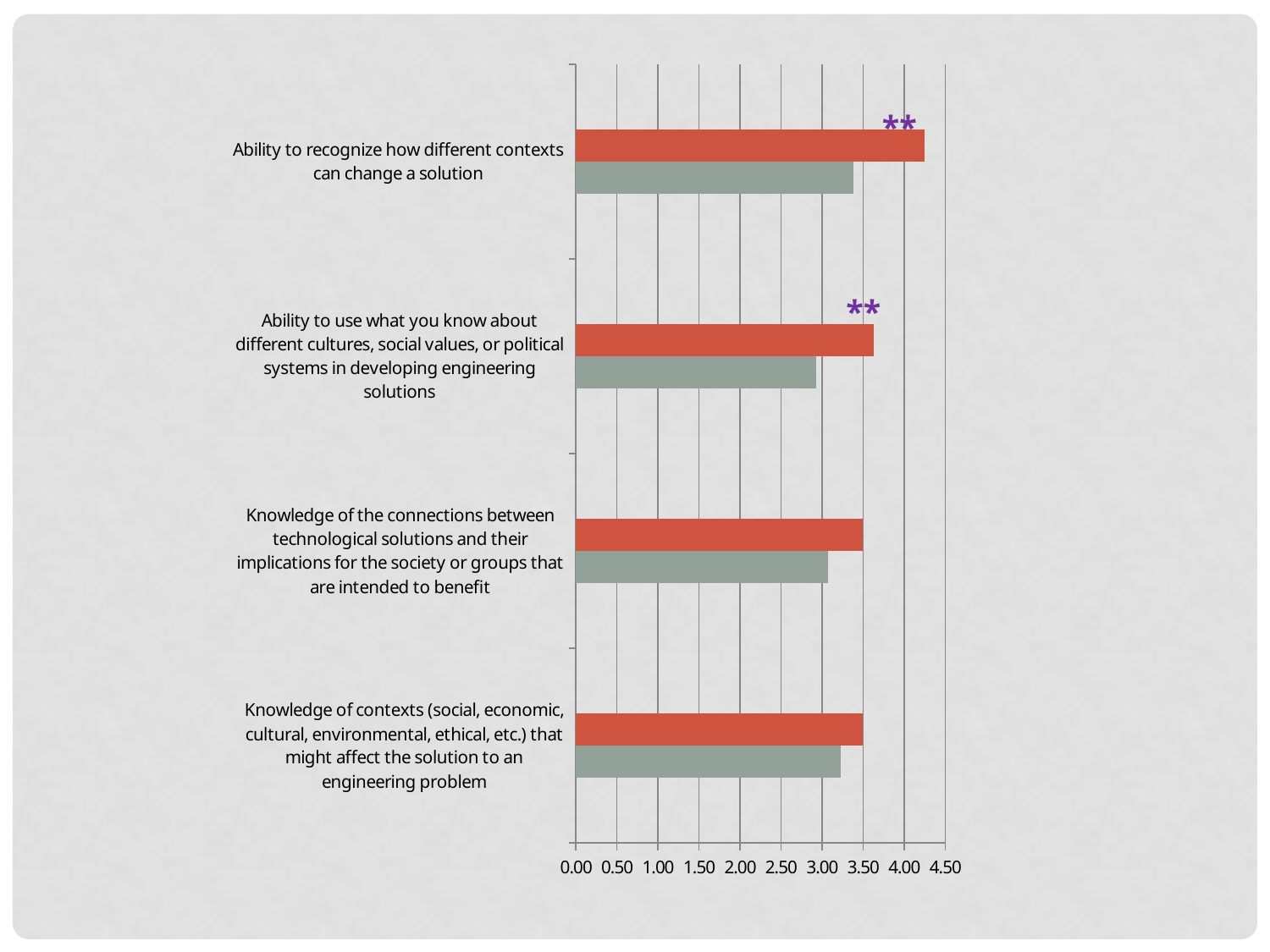
Which is longer: the red bar for "Ability to recognize how different contexts can change a solution" or the red bar for "Ability to use what you know about different cultures, social values, or political systems in developing engineering solutions"? Ability to recognize how different contexts can change a solution Is the gray bar for "Ability to recognize how different contexts can change a solution" greater or less than 3.50? less Is the red bar for "Knowledge of contexts (social, economic, cultural, environmental, ethical, etc.) that might affect the solution to an engineering problem" greater or less than 3.00? greater Is the red bar for "Ability to recognize how different contexts can change a solution" greater or less than 4.00? greater What is the highest value shown on the horizontal axis? 4.50 Which category has the longest red bar? Ability to recognize how different contexts can change a solution How many categories are shown on the chart? 4 What kind of chart is shown on the slide? bar chart For "Knowledge of the connections between technological solutions and their implications for the society or groups that are intended to benefit", which bar is longer, the red or the gray? red Which category has the shortest gray bar? Ability to use what you know about different cultures, social values, or political systems in developing engineering solutions How many categories are marked with a purple double asterisk (**)? 2